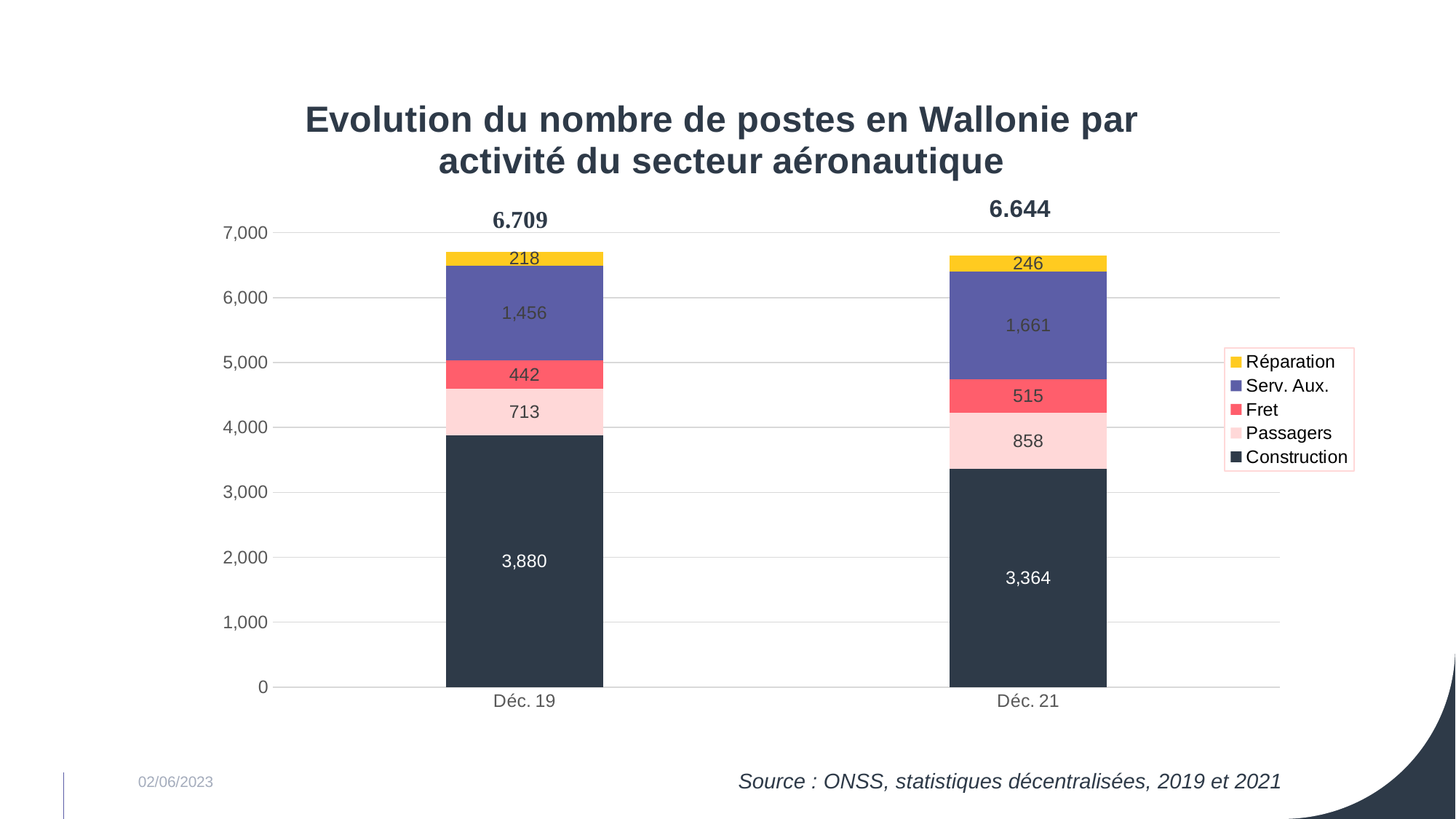
What is the value for Construction in Déc. 19? 3,880 What is the value for Passagers in Déc. 19? 713 What is the total shown above the Déc. 19 stacked bar? 6.709 How many categories are shown on the x axis? 2 What is the total shown above the Déc. 21 stacked bar? 6.644 What is the value for Serv. Aux. in Déc. 21? 1,661 Which series has the lowest value in Déc. 21? Réparation What is the value for Réparation in Déc. 21? 246 What kind of chart is shown on the slide? Stacked bar chart What is the difference between the Fret values for Déc. 21 and Déc. 19? 73 Which is larger, Construction in Déc. 19 or Construction in Déc. 21? Déc. 19 How many series does the legend list? 5